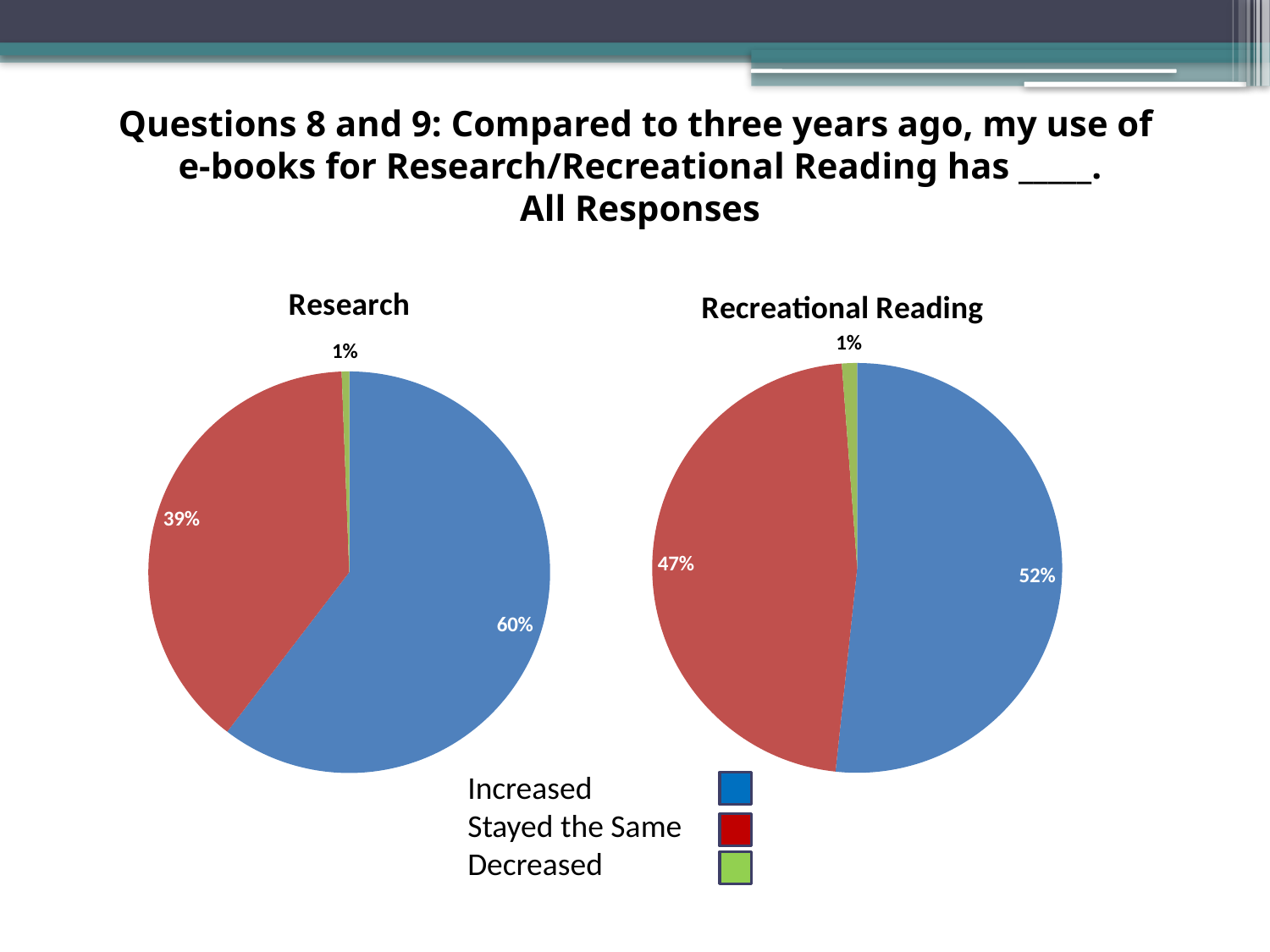
How many categories does the legend list for the pie charts? 3 In the Research pie chart, what is the difference between the Increased and Stayed the Same shares? 21% In the Recreational Reading pie chart, what percentage of responses were Stayed the Same? 47% In the Research pie chart, which response category has the largest share? Increased Which chart has the larger share for Increased, Research or Recreational Reading? Research In the Research pie chart, what percentage of responses were Increased? 60% In the Recreational Reading pie chart, what percentage of responses were Decreased? 1% In the Research pie chart, what percentage of responses were Stayed the Same? 39% In the Recreational Reading pie chart, which response category has the smallest share? Decreased In the Recreational Reading pie chart, what percentage of responses were Increased? 52% Which colour represents Stayed the Same in the legend? Red What type of chart is used for the Research data? Pie chart